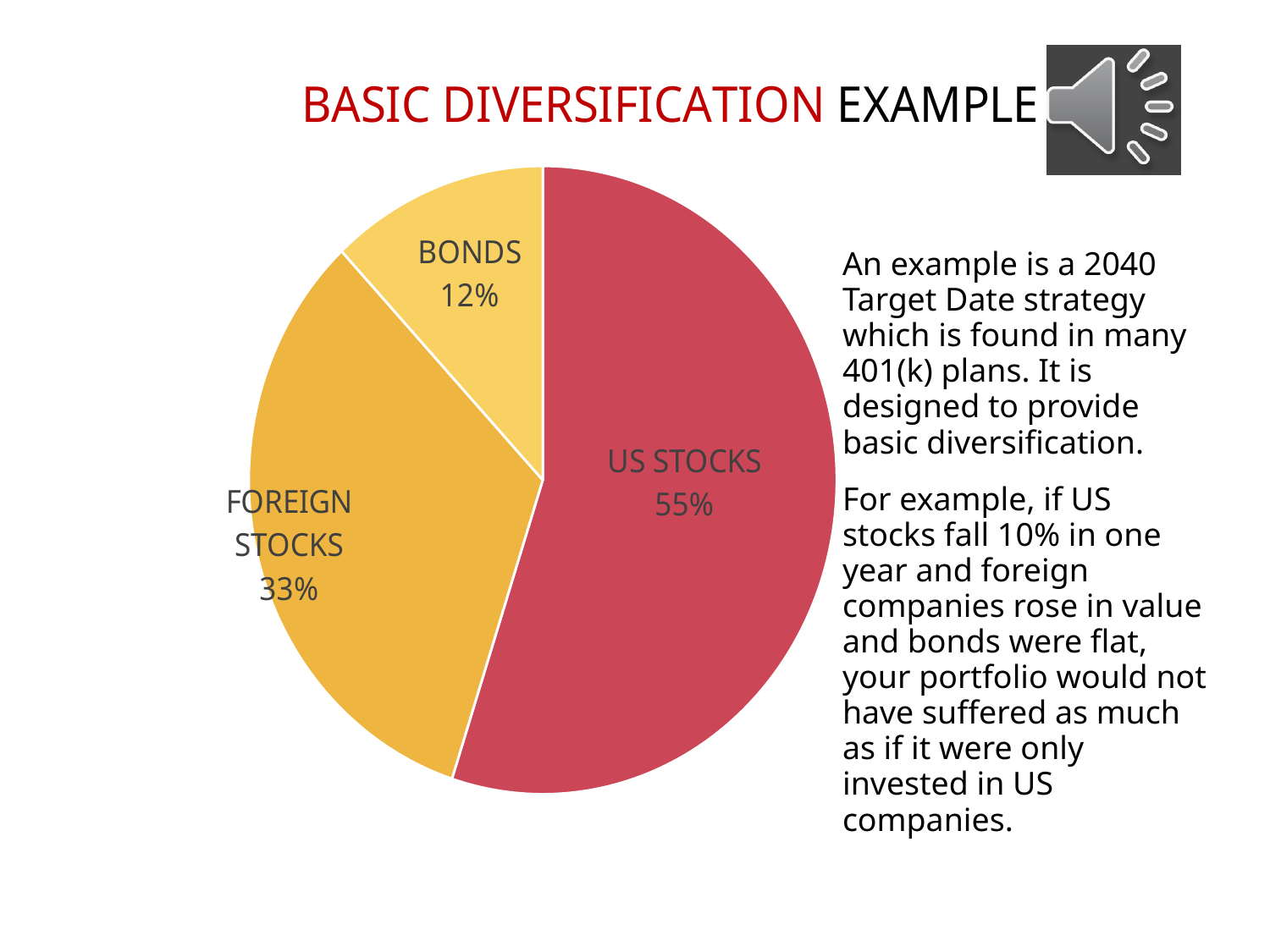
What is the difference in percentage points between US STOCKS and FOREIGN STOCKS? 22 What is the difference in percentage points between FOREIGN STOCKS and BONDS? 21 What share of the pie is BONDS? 12% What kind of chart is shown on the slide? pie chart What is the title of the slide containing the pie chart? BASIC DIVERSIFICATION EXAMPLE What share of the pie is FOREIGN STOCKS? 33% Which is larger, the FOREIGN STOCKS slice or the BONDS slice? FOREIGN STOCKS What share of the pie is US STOCKS? 55% How many slices does the pie chart have? 3 Which slice of the pie is the largest? US STOCKS Which slice of the pie is the smallest? BONDS What colour is the US STOCKS slice? red